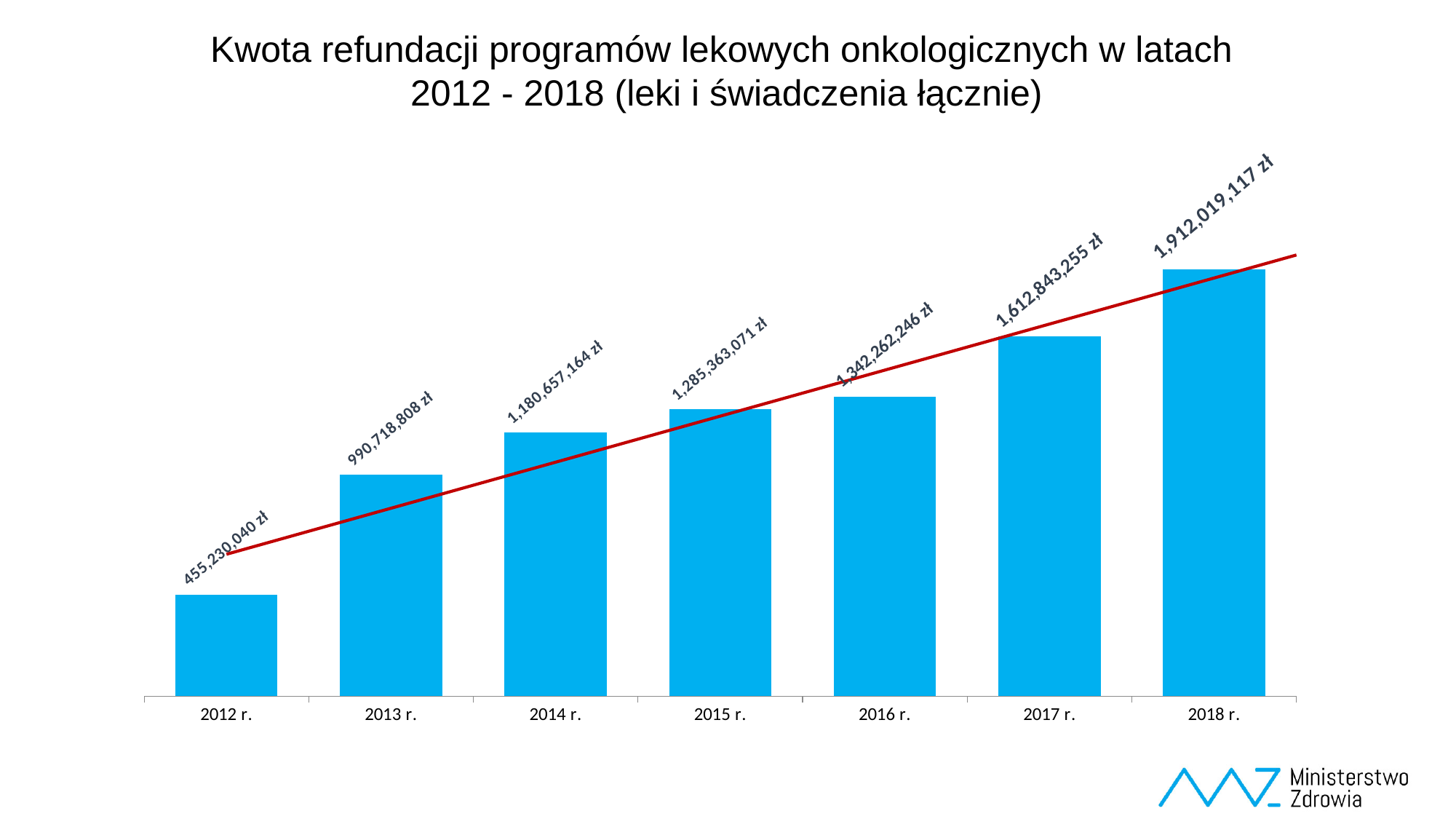
How many years are shown on the x axis? 7 What is the difference between the values for 2018 r. and 2017 r.? 299,175,862 zł Which year has the lowest value? 2012 r. Which is larger, the value for 2014 r. or the value for 2016 r.? 2016 r. What colour are the bars? blue What kind of chart is this? bar chart Which year has the highest value? 2018 r. Do the values rise or fall from 2012 r. to 2018 r.? rise What is the value for 2012 r.? 455,230,040 zł What is the difference between the values for 2013 r. and 2012 r.? 535,488,768 zł What is the value for 2017 r.? 1,612,843,255 zł What is the value for 2015 r.? 1,285,363,071 zł